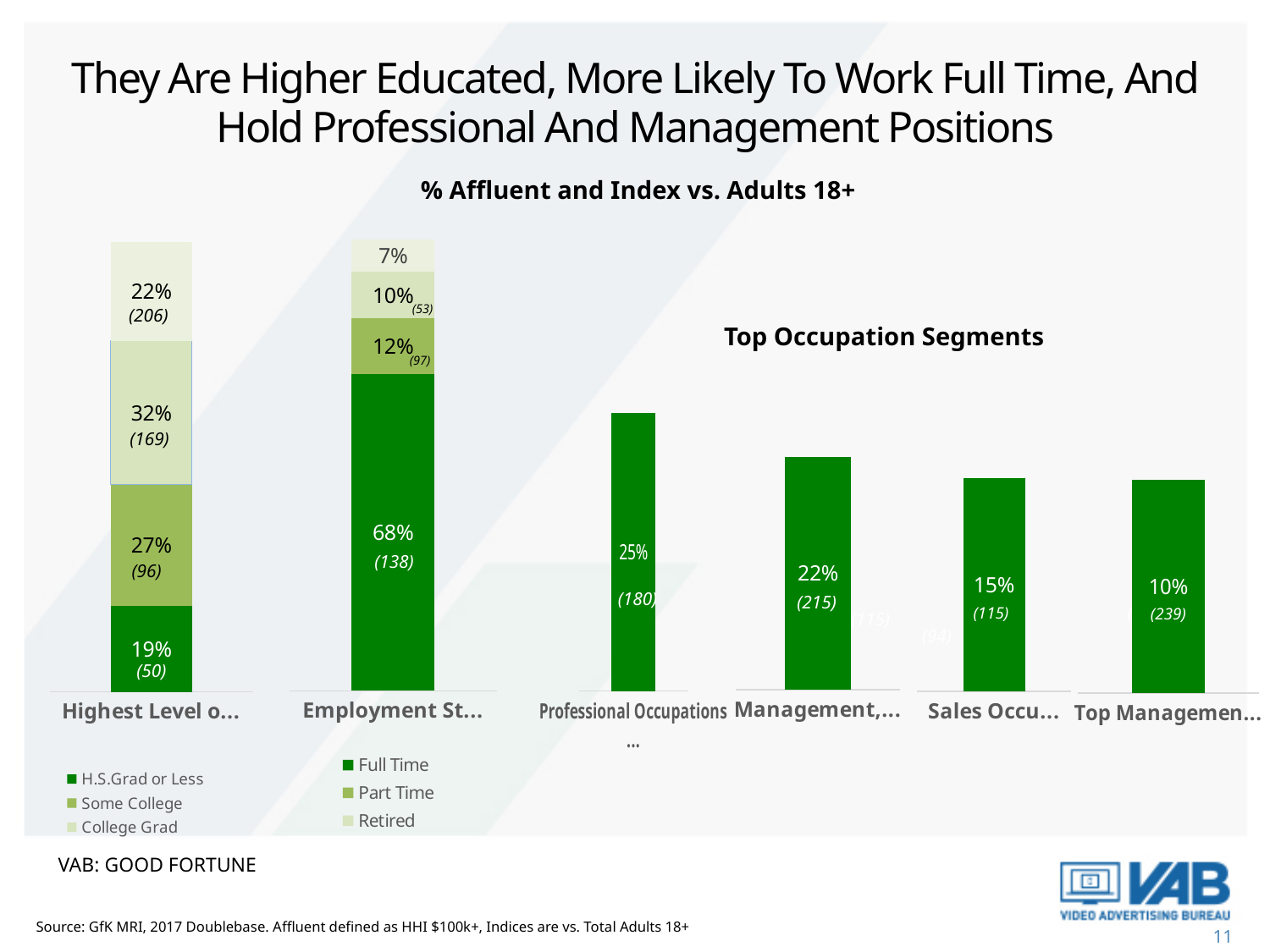
In the Highest Level of Education stacked bar, what is the index shown for H.S. Grad or Less? 50 In the Top Occupation Segments chart, what is the index shown for Top Management? 239 In the Top Occupation Segments chart, which occupation segment has the highest percentage? Professional Occupations In the Top Occupation Segments chart, what is the difference in percentage between Management and Sales Occupations? 7% In the Top Occupation Segments chart, which occupation segment has the lowest percentage? Top Management How many entries does the legend for the Employment Status chart list? 3 In the Top Occupation Segments chart, do the percentages rise or fall from left to right? fall In the Top Occupation Segments chart, what is the value for Professional Occupations? 25% In the Employment Status stacked bar, which is larger, Part Time or Retired? Part Time In the Top Occupation Segments chart, how many occupation segments are shown? 4 In the Highest Level of Education stacked bar, what is the value for Some College? 27% In the Employment Status stacked bar, what is the value for Full Time? 68%